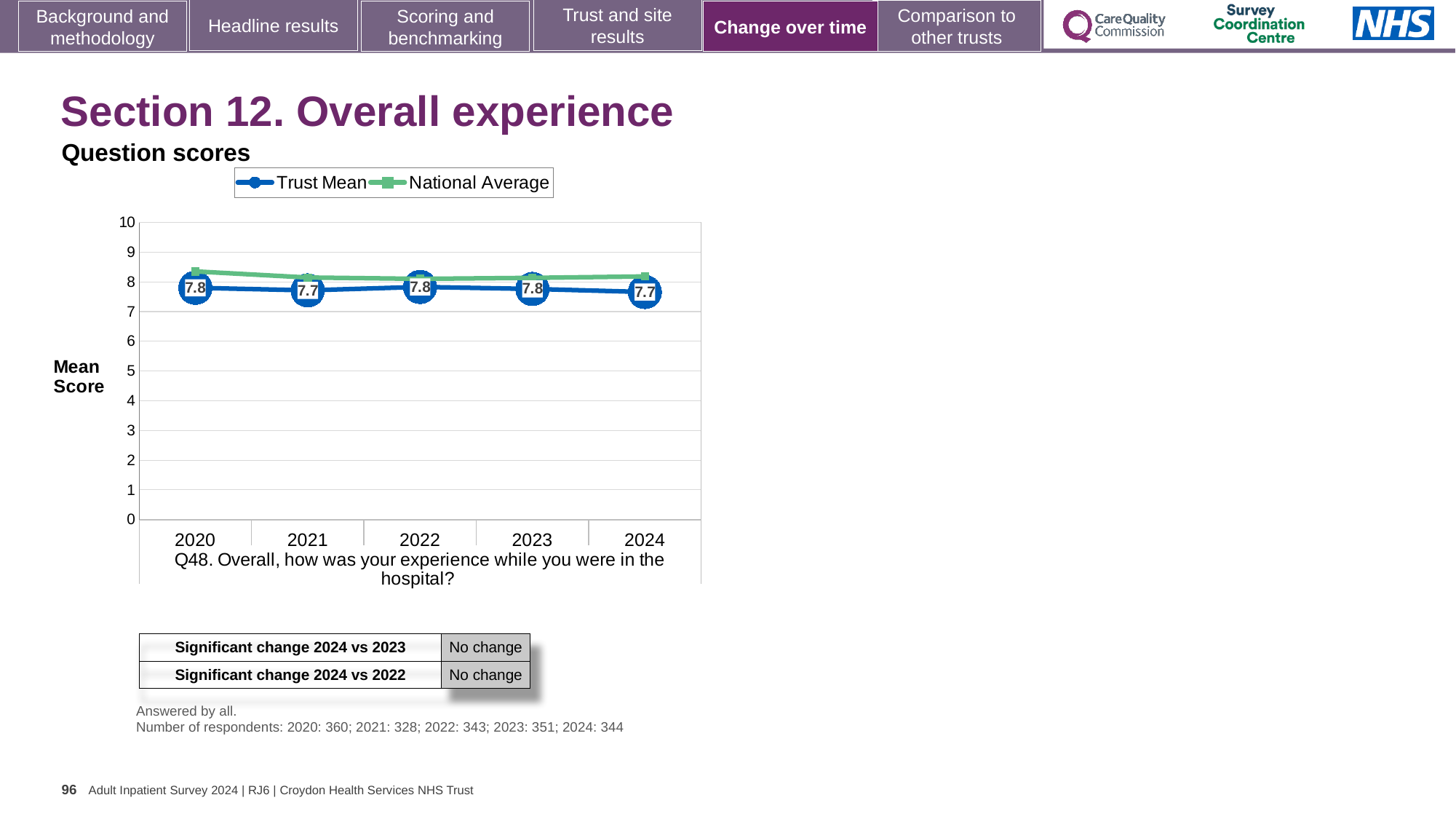
How many series does the chart legend list? 2 What is the Trust Mean score for 2024? 7.7 What is the Trust Mean score for 2023? 7.8 Is the Trust Mean value for 2023 greater or less than 8? less Which year has the higher Trust Mean score, 2022 or 2024? 2022 What is the Trust Mean score for 2021? 7.7 What are the two series named in the chart legend? Trust Mean and National Average In 2020, which is higher: the Trust Mean or the National Average? National Average How many years are plotted on the x axis of the chart? 5 What kind of chart is shown on the slide? Line chart What is the difference between the Trust Mean scores for 2020 and 2021? 0.1 What is the Trust Mean score for 2020? 7.8